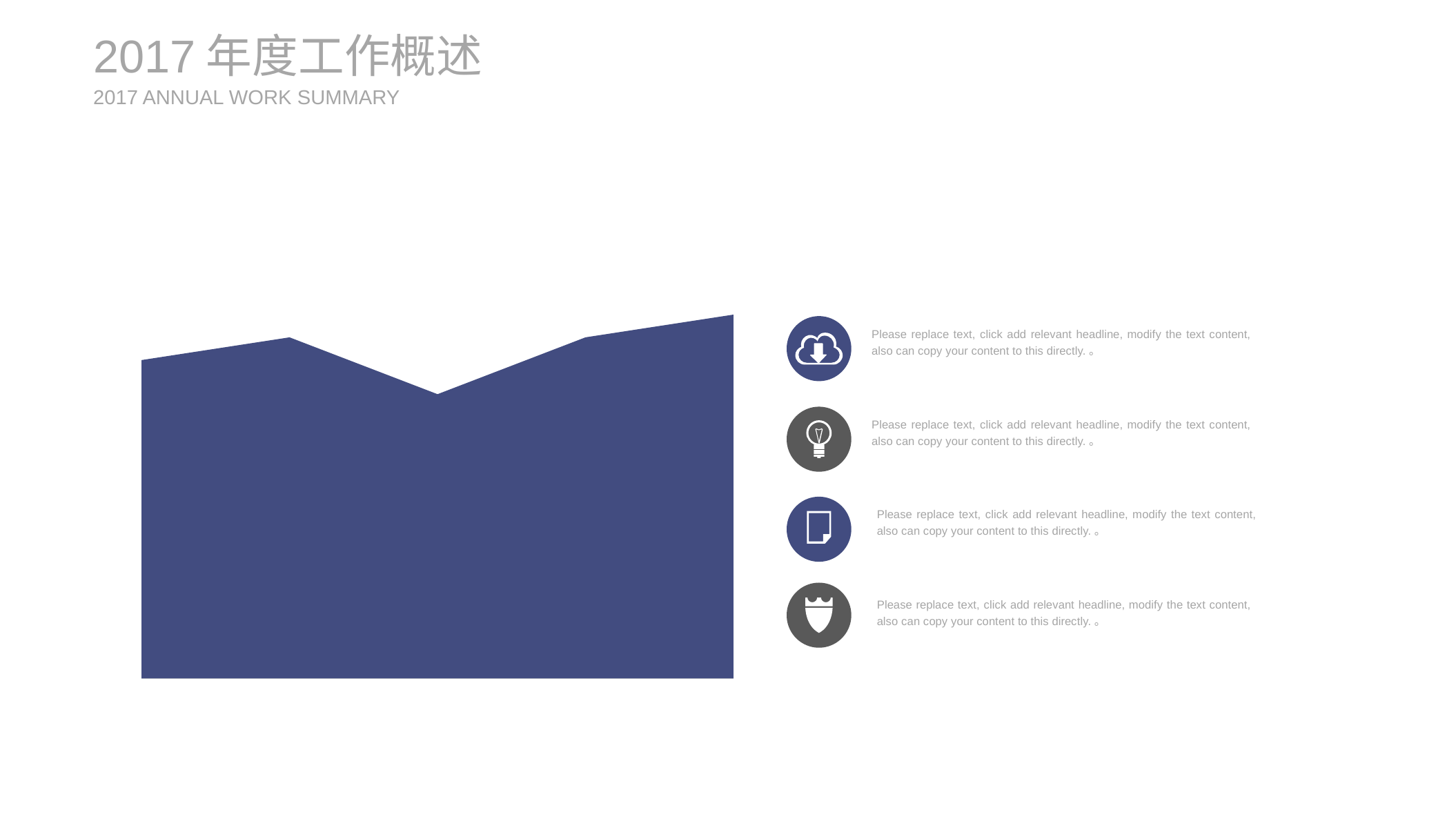
Does the chart display a legend? no What colour is the filled area in the chart? blue Does the area chart rise steadily from left to right, or does it dip in the middle before rising? dips in the middle before rising What kind of chart is shown on the left of the slide? area chart Is the value at the right end of the area chart higher or lower than the value at the left end? higher